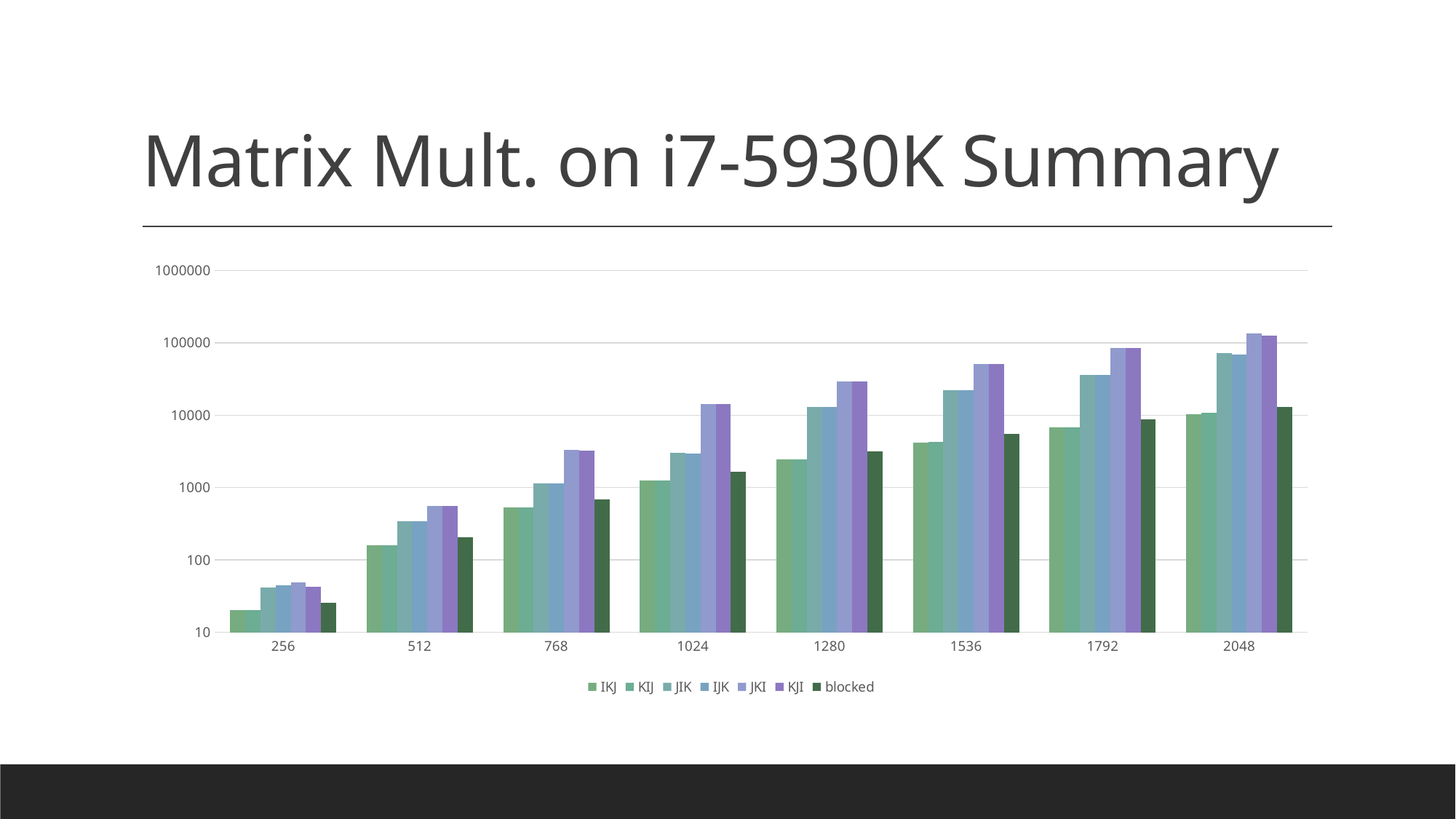
Is the value for JKI at matrix size 2048 greater or less than 100000? greater Is the value for IKJ at matrix size 256 greater or less than 100? less Which series is listed last in the legend? blocked Is the value for blocked at matrix size 2048 greater or less than 10000? greater Do the values for each series generally rise or fall as the matrix size increases along the x axis? rise What kind of chart is shown on the slide? bar chart What is the title of the slide containing the chart? Matrix Mult. on i7-5930K Summary How many series does the legend list? 7 At matrix size 1536, which is larger: the value for JKI or the value for blocked? JKI How many matrix-size categories are shown on the x axis? 8